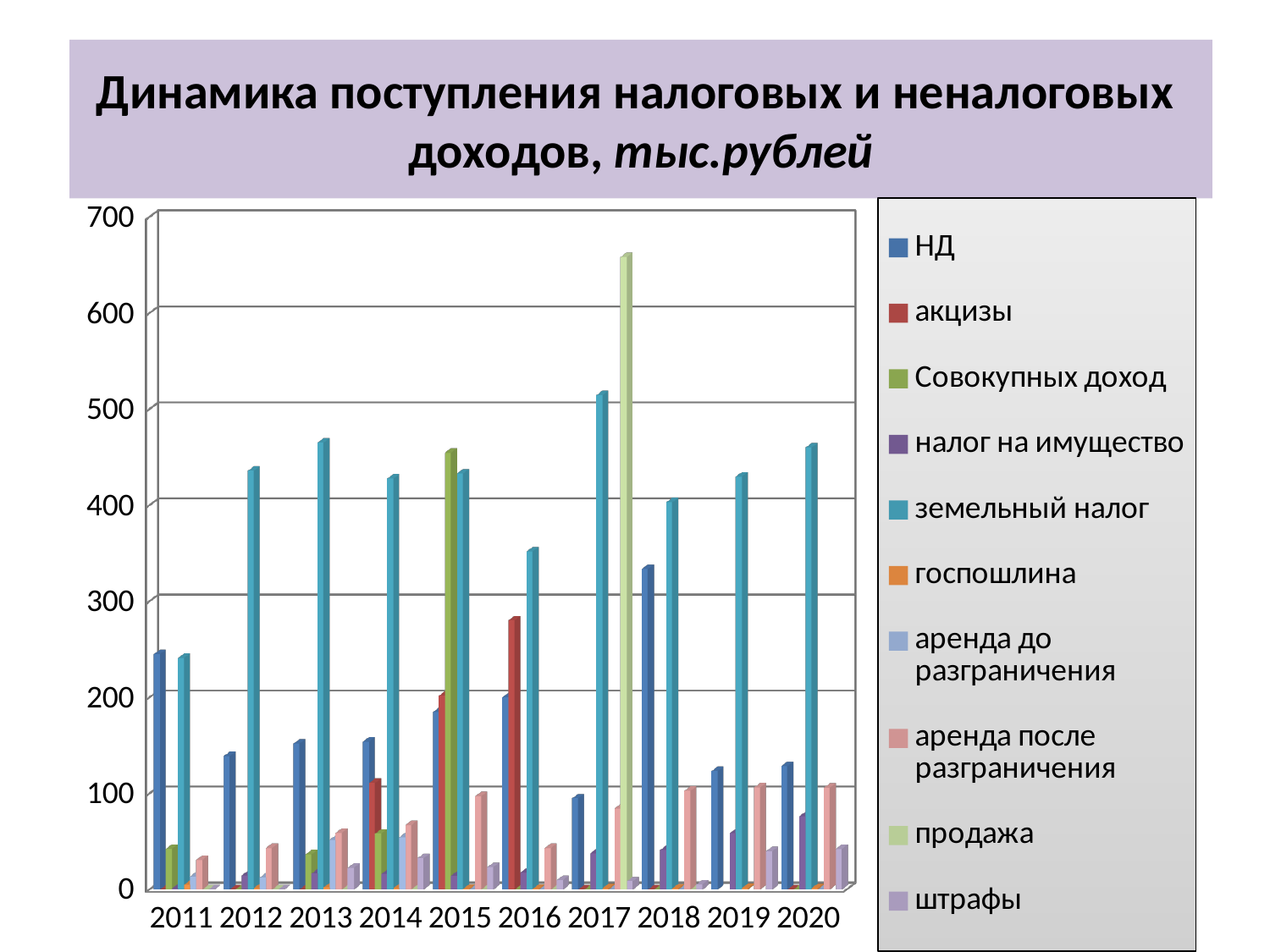
What unit of measurement is given in the chart title? тыс.рублей In which year is the НД bar the tallest? 2018 How many series does the chart legend list? 10 Is the value for продажа in 2017 greater or less than 600? greater How many years are shown along the x axis of the chart? 10 Is the value for акцизы in 2016 greater or less than 300? less What kind of chart is shown on the slide? bar chart In which year is the земельный налог bar the tallest? 2017 Which series has the single tallest bar in the whole chart? продажа In 2012, which is larger: НД or земельный налог? земельный налог Is the value for земельный налог in 2017 greater or less than 500? greater